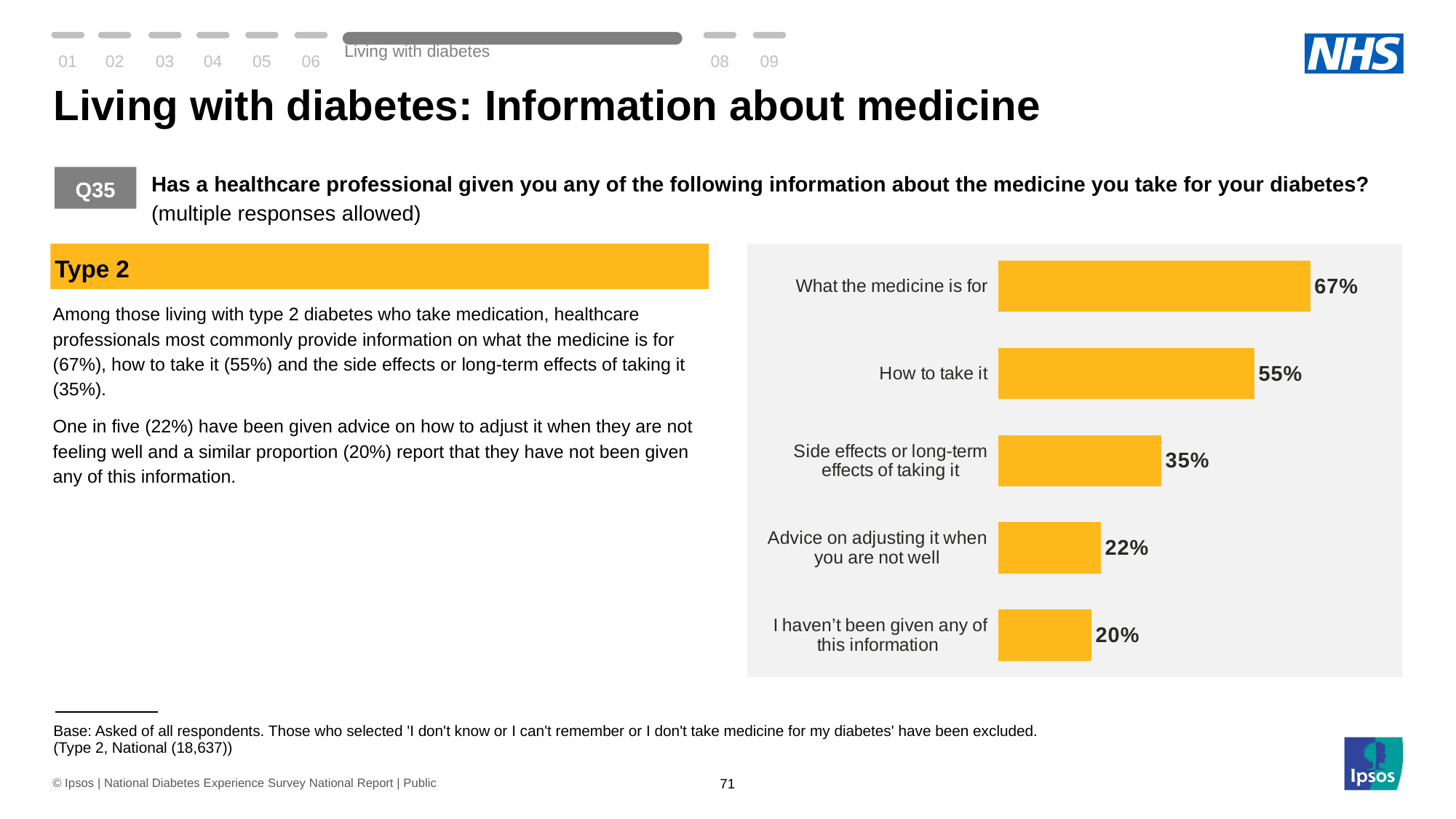
What colour are the bars in the chart? Yellow/orange Which category has the lowest value in the chart? I haven't been given any of this information How many categories are shown in the chart? 5 What percentage of respondents say they haven't been given any of this information? 20% What percentage of respondents were given information on side effects or long-term effects of taking it? 35% What percentage of respondents were given information on how to take it? 55% Which category has the highest value in the chart? What the medicine is for What percentage of respondents were given information on what the medicine is for? 67% What is the difference in percentage points between 'Advice on adjusting it when you are not well' and 'I haven't been given any of this information'? 2 percentage points What type of chart is shown on the slide? Bar chart What is the difference in percentage points between 'What the medicine is for' and 'How to take it'? 12 percentage points Which is larger: the value for 'Side effects or long-term effects of taking it' or the value for 'Advice on adjusting it when you are not well'? Side effects or long-term effects of taking it